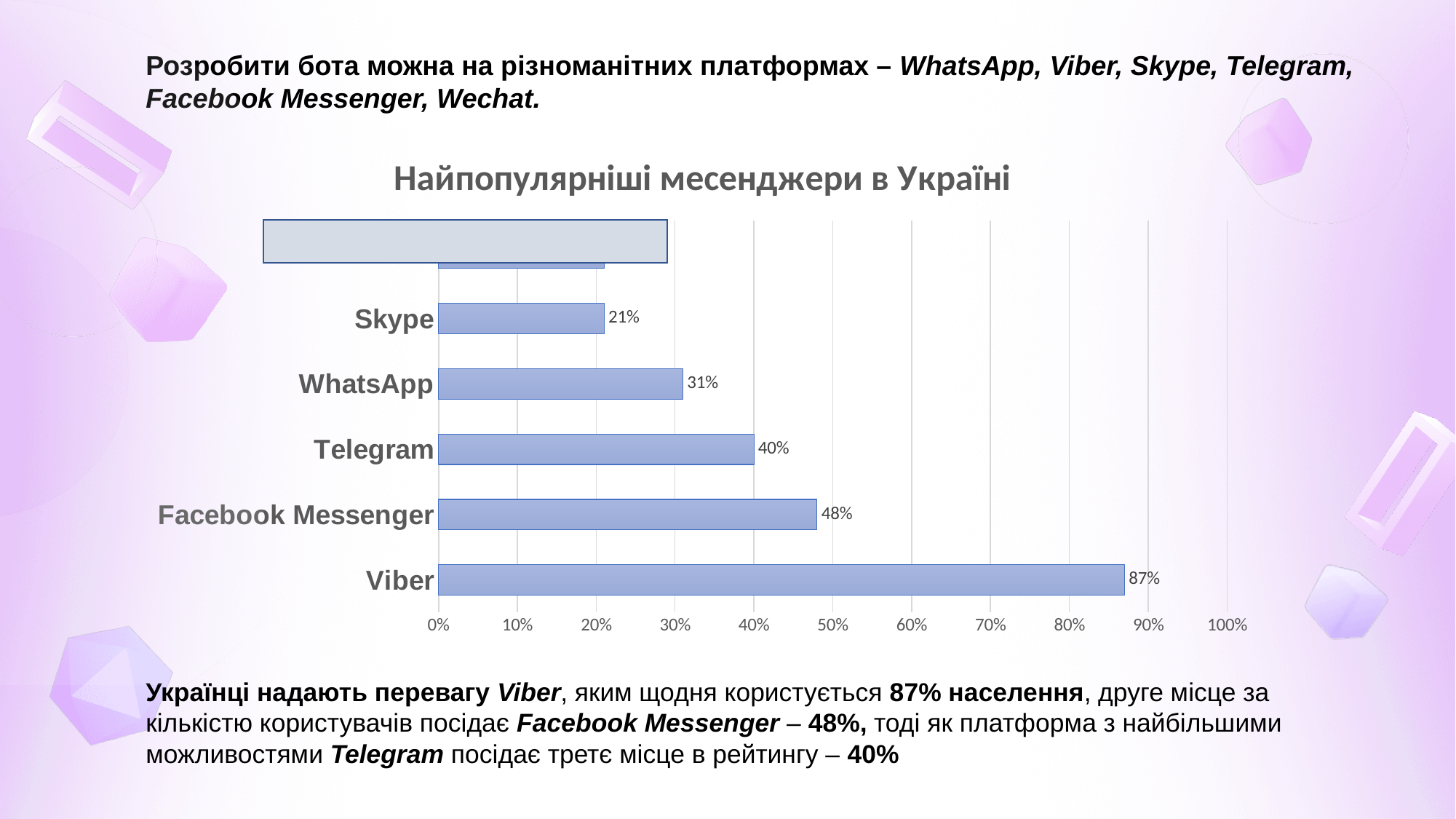
Is the value for Facebook Messenger greater or less than 50%? less What is the value for WhatsApp? 31% What is the value for Telegram? 40% What is the title of the chart? Найпопулярніші месенджери в Україні Which messenger has the highest value? Viber Which is larger, the value for WhatsApp or the value for Telegram? Telegram What is the difference between the values for Viber and Facebook Messenger? 39% What is the value for Facebook Messenger? 48% What is the value for Skype? 21% What kind of chart is shown on the slide? bar chart What is the value for Viber? 87% What is the difference between the values for Telegram and Skype? 19%